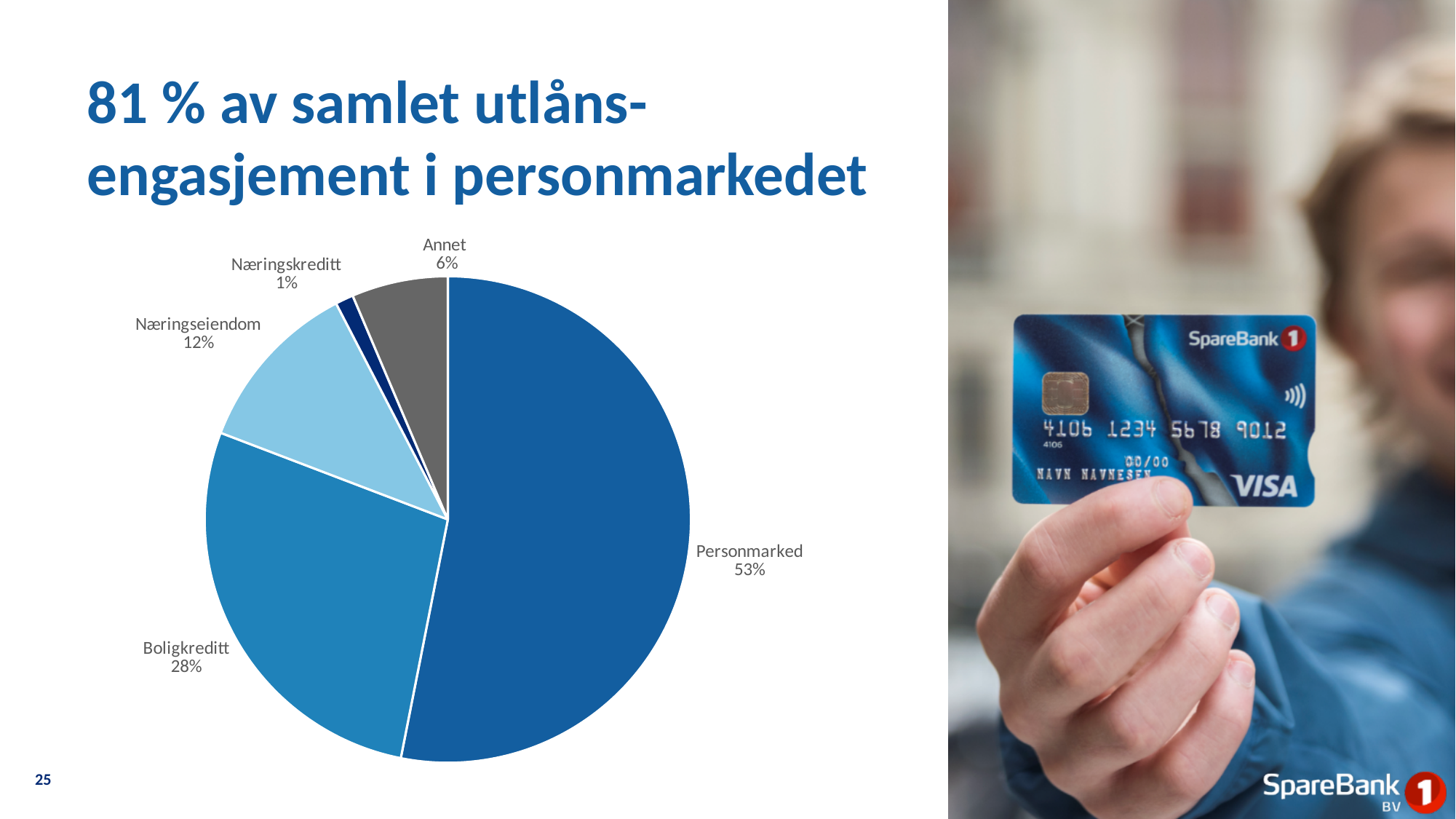
What is the value shown for Annet? 6% Which category has the smallest slice of the pie? Næringskreditt Which is larger, Næringseiendom or Annet? Næringseiendom How many categories are shown in the pie chart? 5 What type of chart is shown on the slide? Pie chart What is the value shown for Boligkreditt? 28% What is the difference in percentage points between Personmarked and Boligkreditt? 25 percentage points What is the value shown for Næringskreditt? 1% What is the combined share of Personmarked and Boligkreditt? 81% What is the value shown for Næringseiendom? 12% What share of the pie does Personmarked represent? 53% Which category has the largest slice of the pie? Personmarked